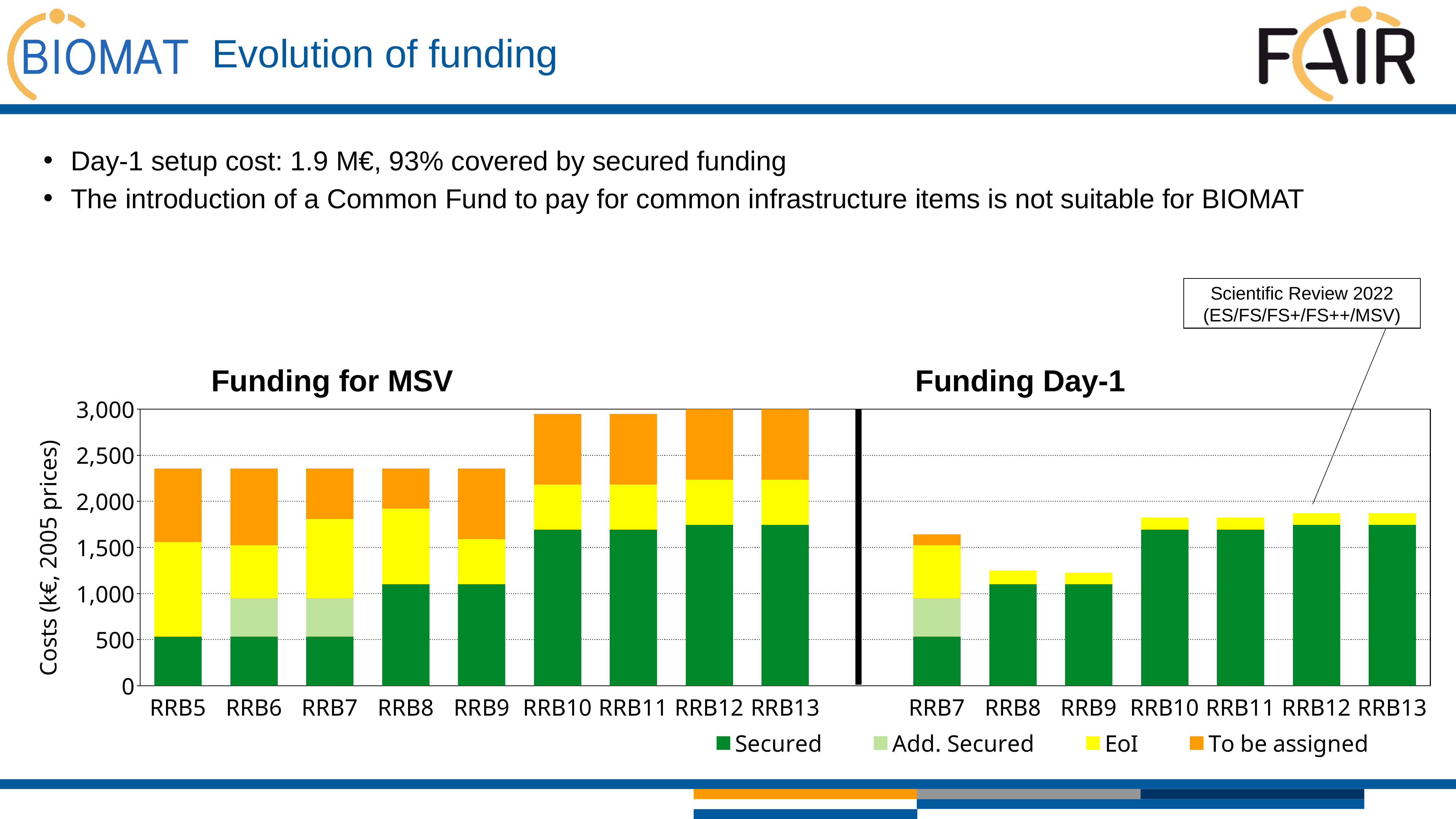
What is the label of the vertical axis? Costs (k€, 2005 prices) How many series does the legend list? 4 In the Funding for MSV section, which has the larger total bar, RRB9 or RRB10? RRB10 In the Funding Day-1 section, which has the larger total bar, RRB7 or RRB8? RRB7 In the Funding for MSV section, is the total bar height for RRB10 greater or less than 2,500? greater What kind of chart is shown on the slide? bar chart In the Funding for MSV section, is the Secured value for RRB10 greater or less than 1,500? greater How many RRB categories are shown in the Funding for MSV section? 9 In the Funding Day-1 section, do the total bar heights rise or fall from RRB9 to RRB10? rise In the Funding Day-1 section, is the total bar height for RRB8 greater or less than 1,500? less How many RRB categories are shown in the Funding Day-1 section? 7